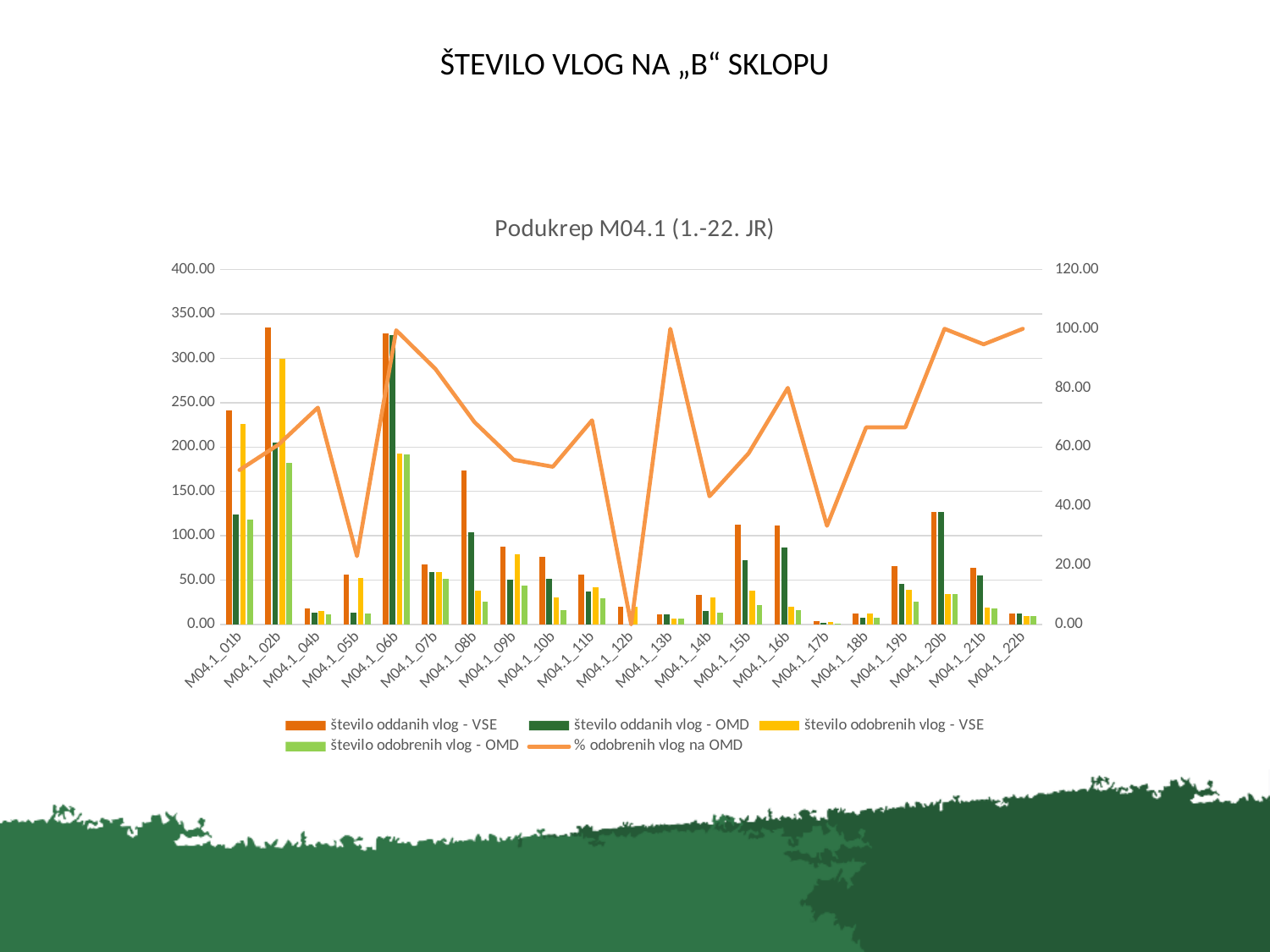
How many categories are shown on the x axis? 21 Is the value of 'število oddanih vlog - OMD' for M04.1_06b greater or less than 300? greater Which is larger, 'število odobrenih vlog - VSE' for M04.1_02b or for M04.1_06b? M04.1_02b What is the title of the chart? Podukrep M04.1 (1.-22. JR) Is the value of '% odobrenih vlog na OMD' for M04.1_13b greater or less than 80? greater Which category has the lowest value for 'število oddanih vlog - VSE'? M04.1_17b Is the value of '% odobrenih vlog na OMD' for M04.1_12b greater or less than 20? less Which is larger, 'število oddanih vlog - VSE' for M04.1_01b or for M04.1_08b? M04.1_01b What kind of chart is this? bar chart with a line How many series does the legend list? 5